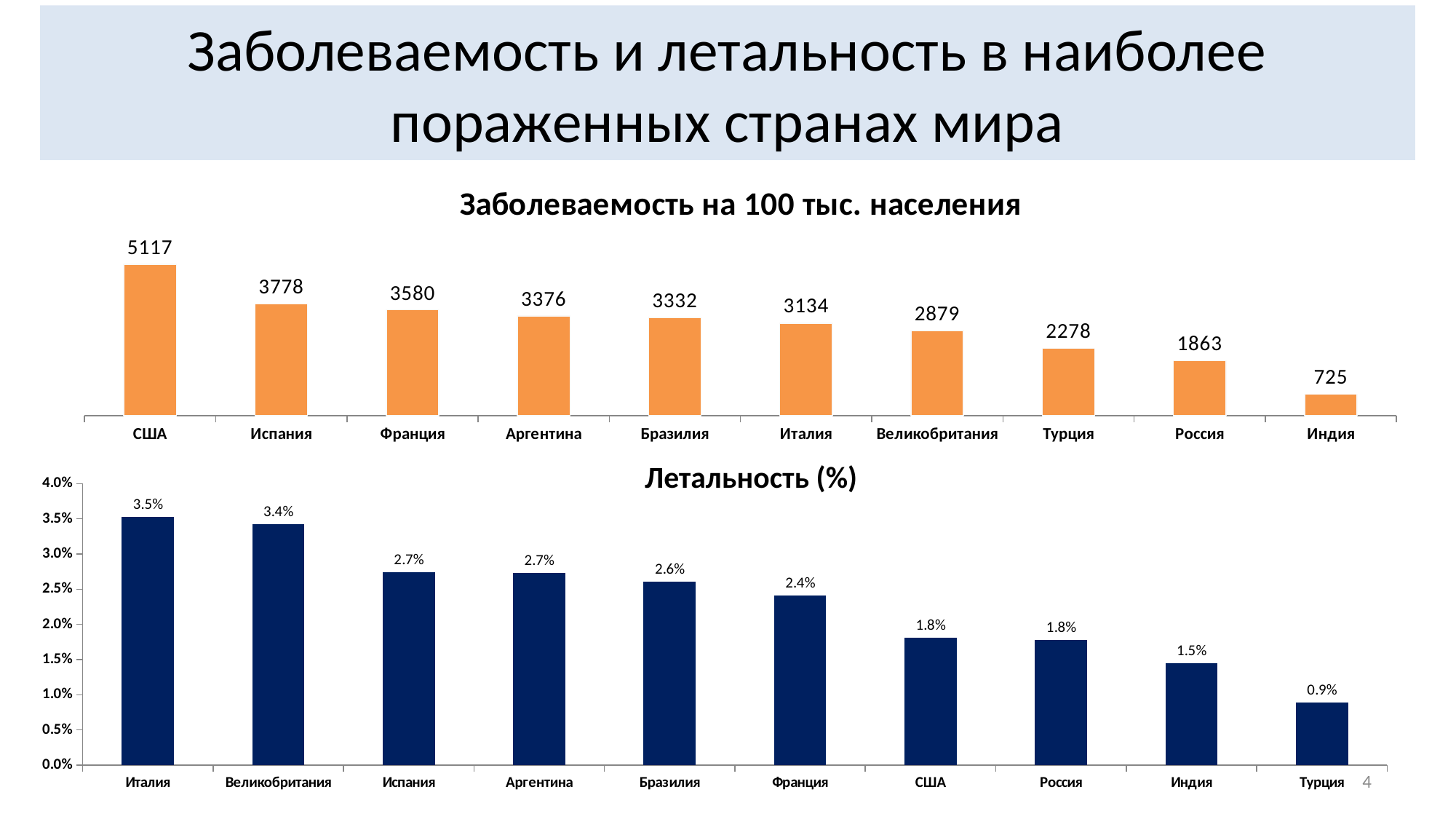
In the chart 'Летальность (%)', which is larger, the value for Великобритания or the value for Бразилия? Великобритания In the chart 'Летальность (%)', what is the value for Франция? 2.4% In the chart 'Летальность (%)', which country has the highest value? Италия What type of chart is the chart 'Летальность (%)'? bar chart In the chart 'Заболеваемость на 100 тыс. населения', which country has the lowest value? Индия In the chart 'Заболеваемость на 100 тыс. населения', what is the value for Франция? 3580 In the chart 'Заболеваемость на 100 тыс. населения', what is the difference between the values for США and Испания? 1339 In the chart 'Заболеваемость на 100 тыс. населения', how many countries are shown? 10 In the chart 'Летальность (%)', what is the difference between the values for Италия and Турция? 2.6% In the chart 'Летальность (%)', which country has the lowest value? Турция In the chart 'Заболеваемость на 100 тыс. населения', do the values rise or fall from left to right? fall In the chart 'Заболеваемость на 100 тыс. населения', which country has the highest value? США